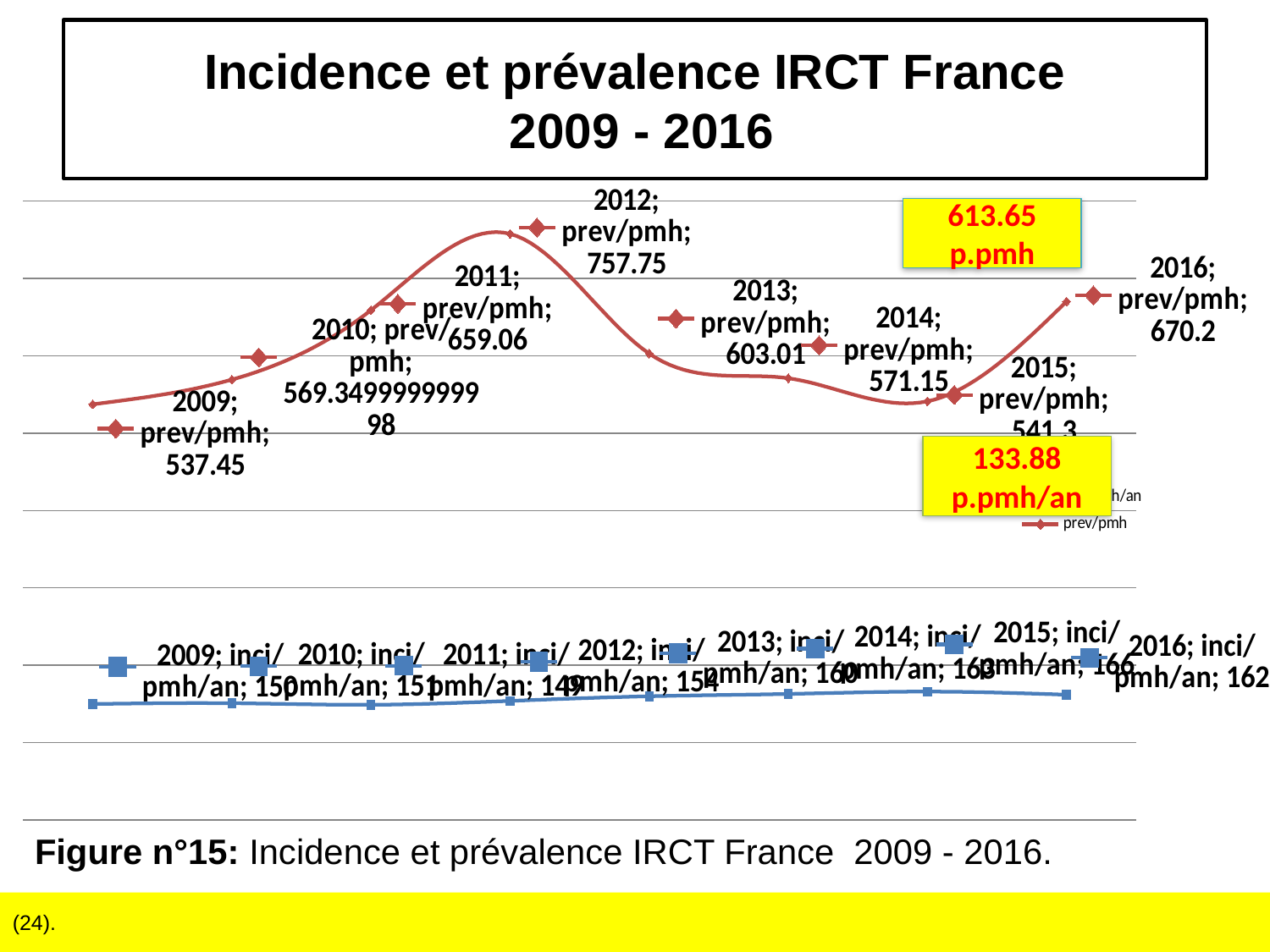
Which year has the larger prev/pmh value, 2013 or 2014? 2013 How many years are plotted on the chart? 8 In which year is the prev/pmh value lowest? 2009 What is the inci/pmh/an value for 2016? 162 What is the prev/pmh value for 2016? 670.2 What is the inci/pmh/an value for 2012? 154 What is the difference between the prev/pmh values for 2012 and 2009? 220.3 Does the prev/pmh series rise or fall from 2009 to 2012? rise What is the prev/pmh value for 2012? 757.75 What kind of chart is shown on the slide? line chart In which year is the prev/pmh value highest? 2012 What is the prev/pmh value for 2009? 537.45